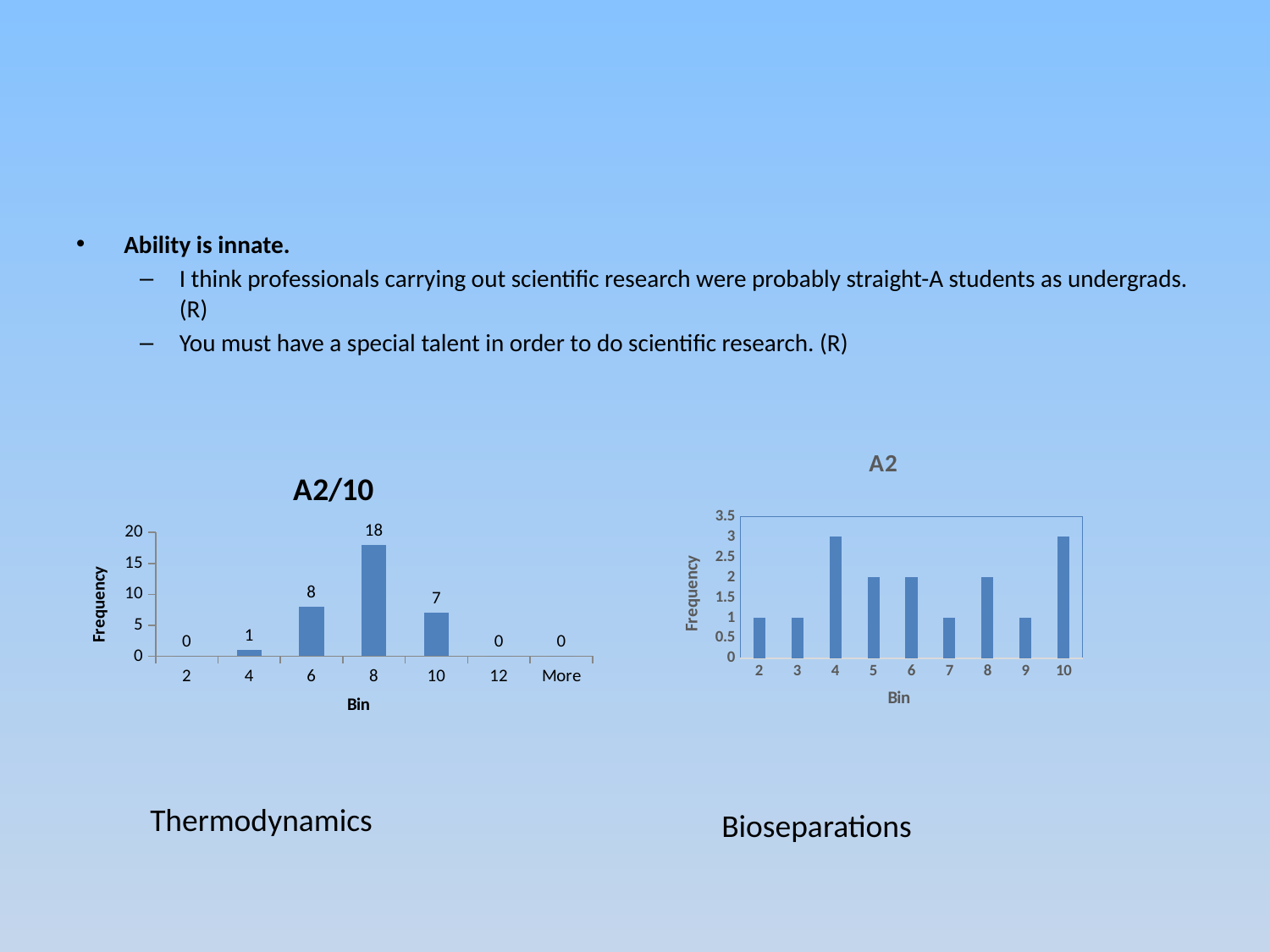
In the A2/10 chart, what is the difference between the frequencies for bin 8 and bin 6? 10 In the A2 chart on the right, what is the frequency for bin 4? 3 What is the label of the y axis on the A2 chart on the right? Frequency How many bins are shown on the x axis of the A2 chart on the right? 9 In the A2/10 chart, what is the frequency for bin 8? 18 In the A2/10 chart, what is the frequency for bin 10? 7 In the A2/10 chart, which bin has the highest frequency? 8 In the A2 chart on the right, is the frequency for bin 5 greater or less than 1.5? greater In the A2 chart on the right, what is the frequency for bin 7? 1 What kind of chart is the A2/10 chart? bar chart In the A2/10 chart, which is larger, the frequency for bin 6 or for bin 10? bin 6 How many bins are shown on the x axis of the A2/10 chart? 7